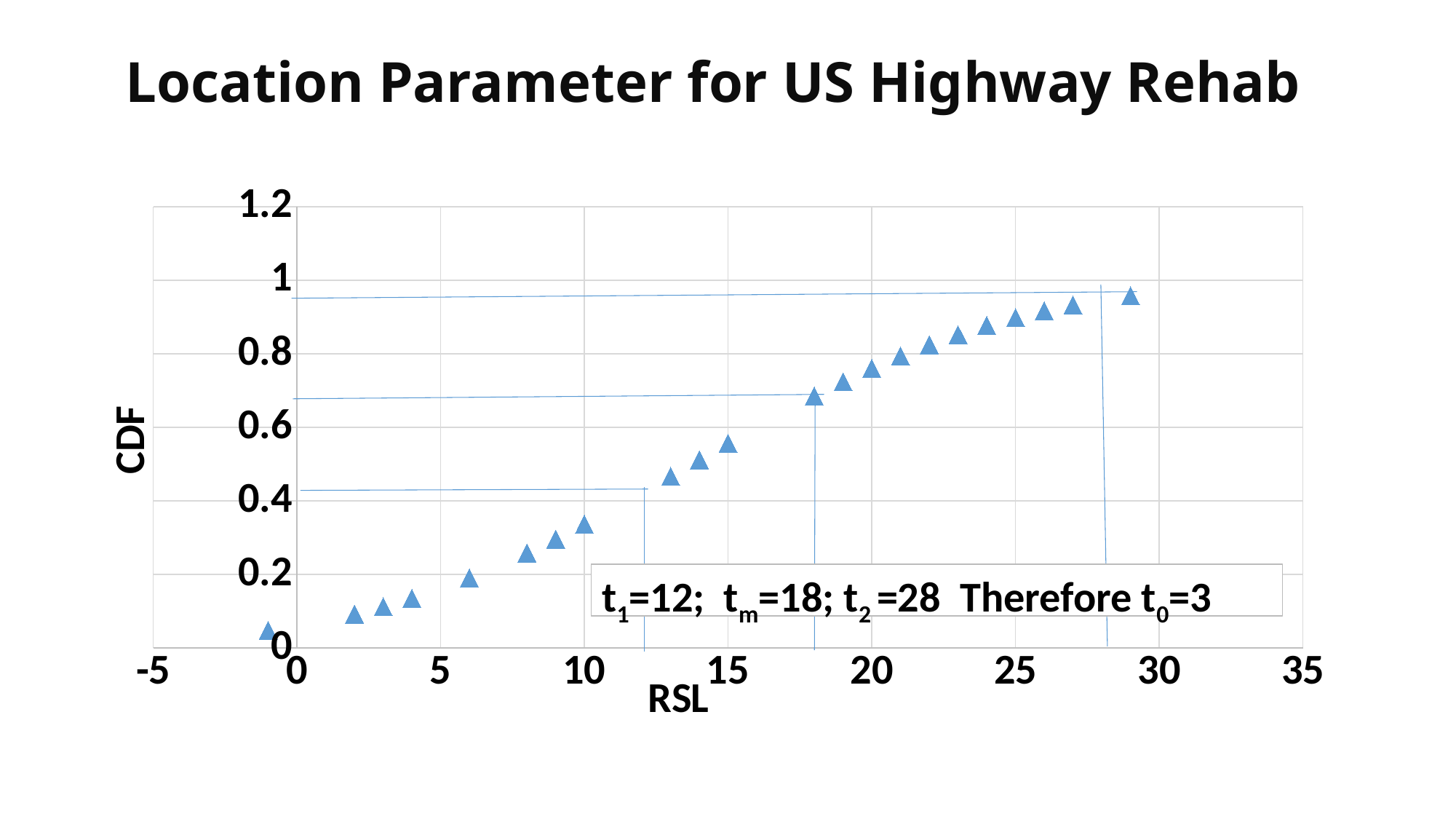
Is the CDF value at RSL 29 greater or less than 1? less Which has the larger CDF value, RSL 13 or RSL 15? RSL 15 At which RSL value is the CDF highest? 29 Do the CDF values rise or fall as RSL increases along the x axis? rise Is the CDF value at RSL 10 greater or less than 0.4? less Is the CDF value at RSL 18 greater or less than 0.6? greater Which has the larger CDF value, RSL 20 or RSL 10? RSL 20 What is the title of the chart? Location Parameter for US Highway Rehab According to the text box on the chart, what is the value of t0? 3 What kind of chart is shown on the slide? scatter plot